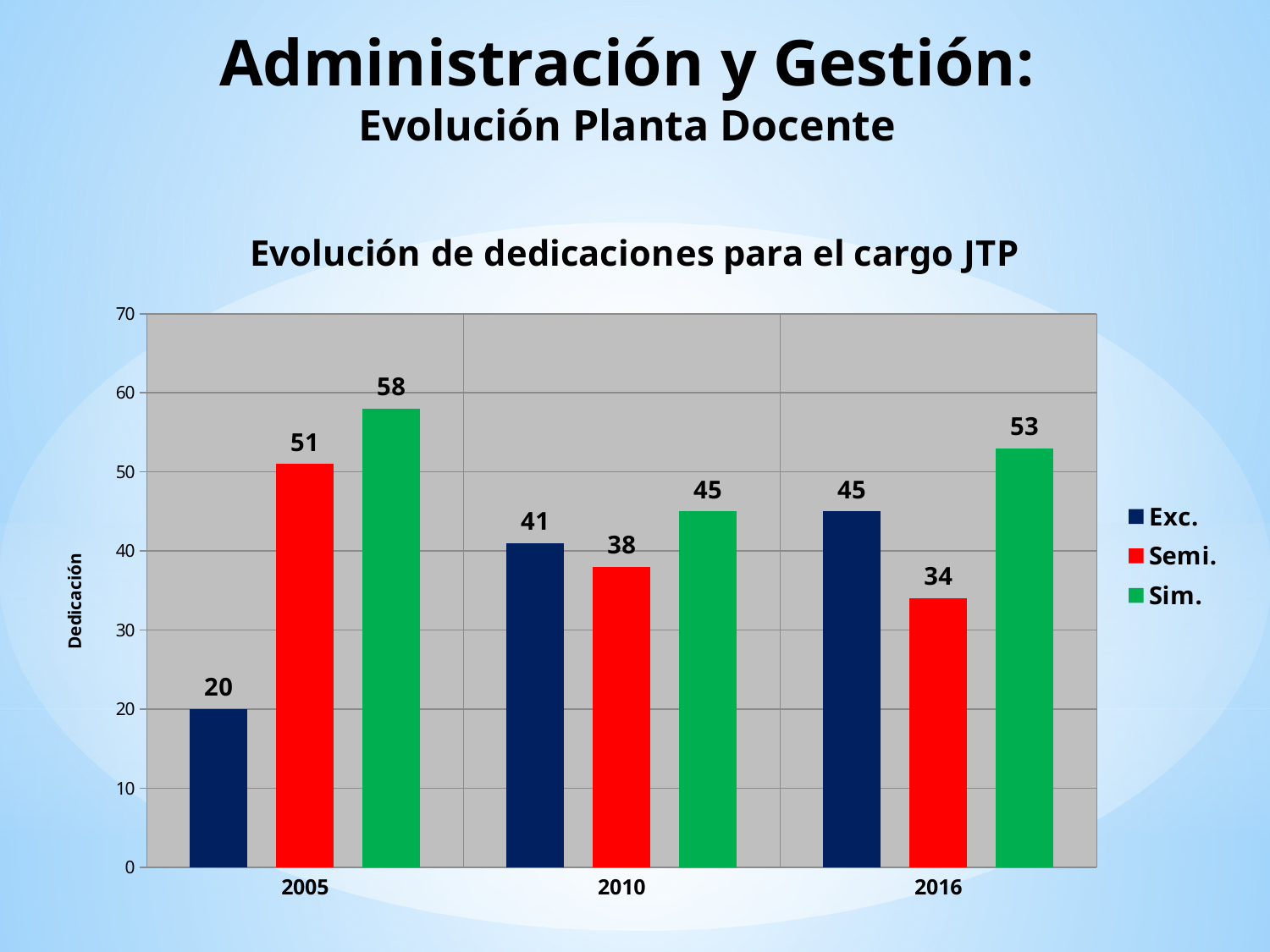
What is the value for Sim. in 2016? 53 What is the difference between the Sim. value and the Exc. value in 2005? 38 Does the Semi. series rise or fall from 2005 to 2016? fall Which is larger in 2016, Exc. or Semi.? Exc. Which year has the highest value for Sim.? 2005 How many years are shown on the x axis? 3 How many series does the legend list? 3 What is the value for Exc. in 2005? 20 What is the title of the chart? Evolución de dedicaciones para el cargo JTP What kind of chart is this? bar chart Which year has the lowest value for Exc.? 2005 What is the value for Semi. in 2010? 38